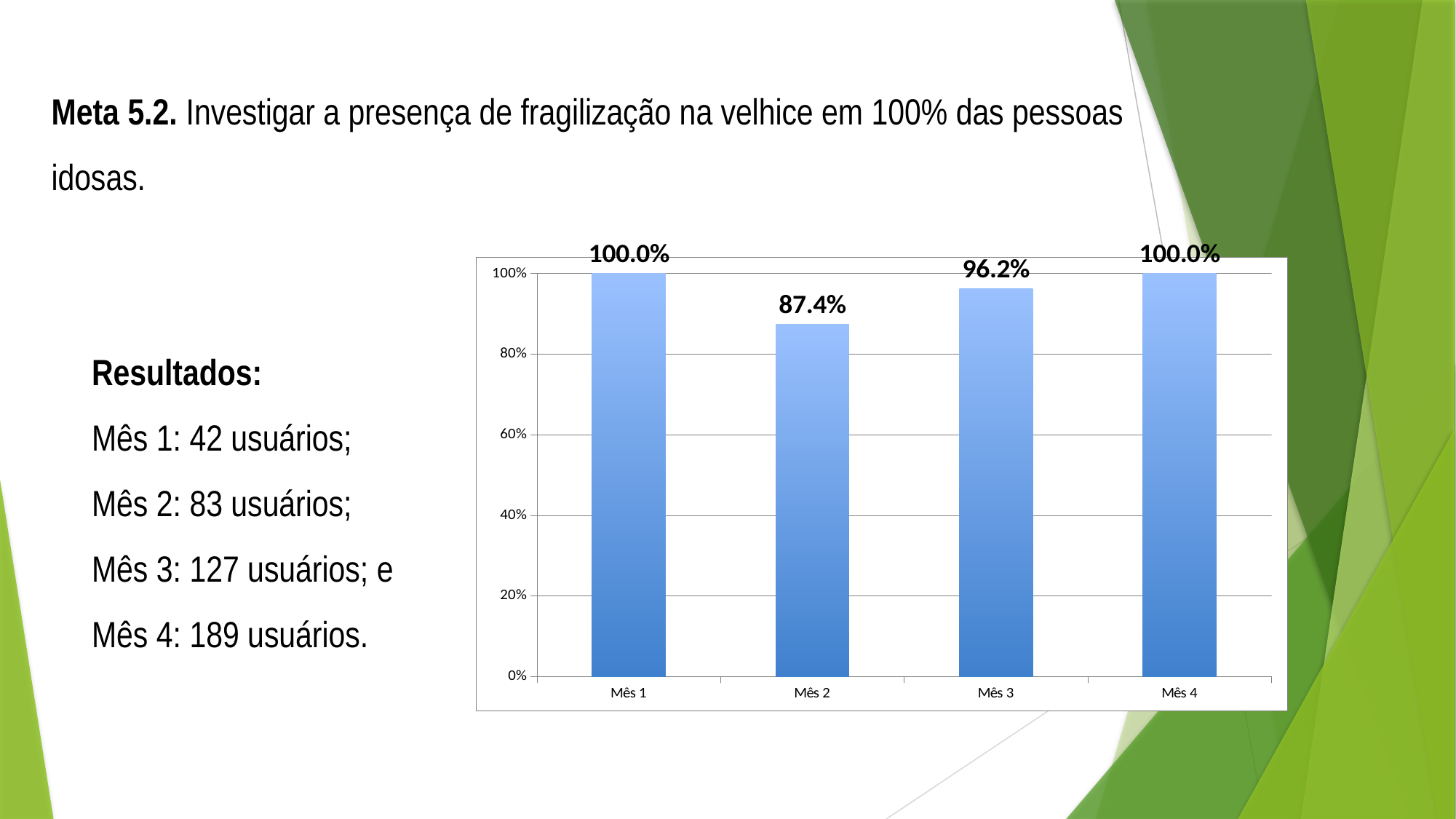
What is the value for Mês 3? 96.2% What kind of chart is shown on the slide? bar chart Is the value for Mês 2 greater or less than 80%? greater What is the difference between the values for Mês 4 and Mês 3? 3.8% What is the value for Mês 1? 100.0% What is the highest value shown on the y axis? 100% How many categories are shown on the x axis? 4 What is the value for Mês 2? 87.4% Do the values rise or fall from Mês 2 to Mês 4? rise Which is larger, the value for Mês 2 or the value for Mês 3? Mês 3 Which month has the lowest value? Mês 2 What is the difference between the values for Mês 3 and Mês 2? 8.8%